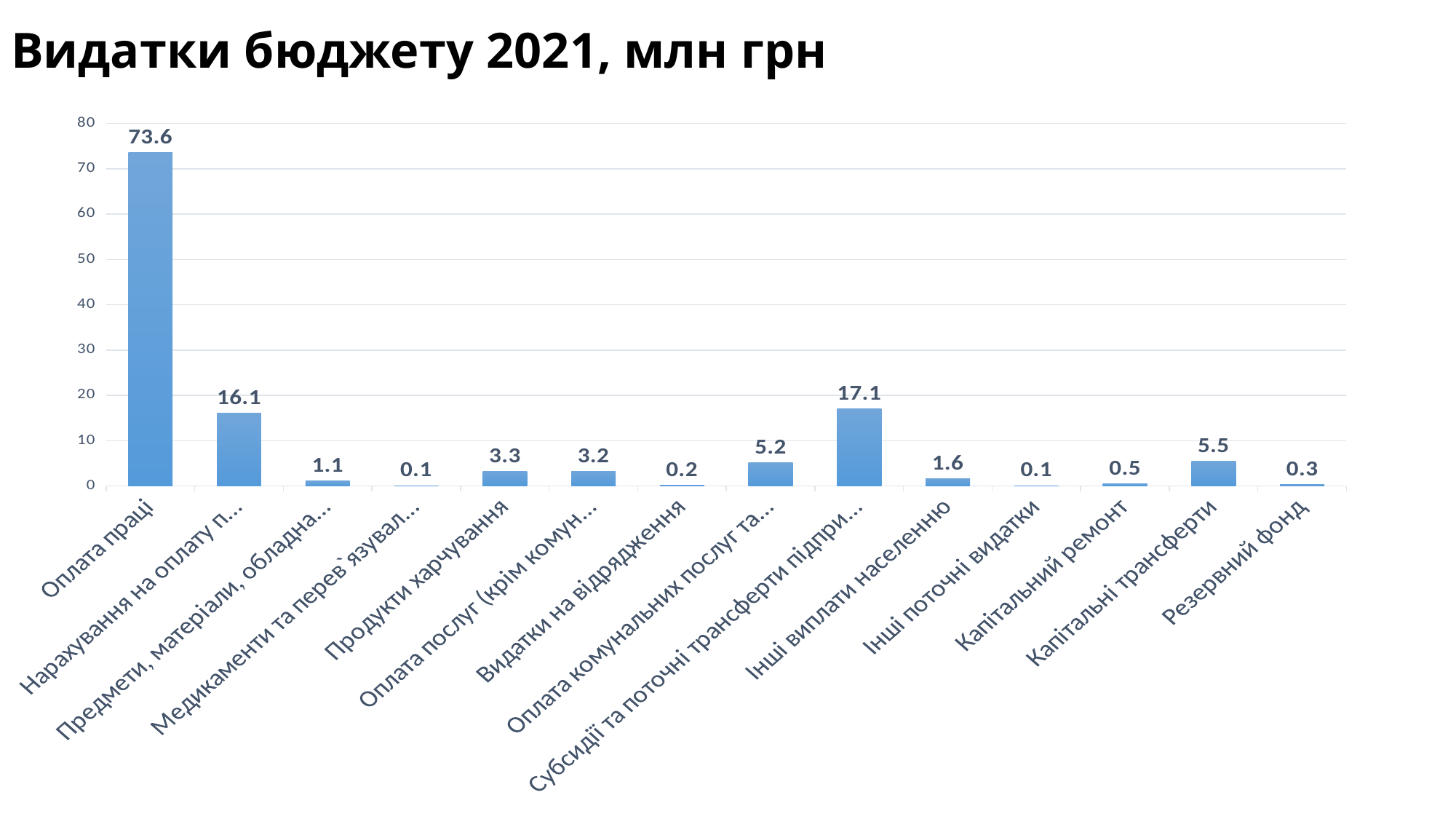
What is the difference between the values for Оплата праці and Нарахування на оплату п...? 57.5 What is the value for Інші виплати населенню? 1.6 What is the value for Резервний фонд? 0.3 What is the title of the chart? Видатки бюджету 2021, млн грн How many categories are shown in the chart? 14 What is the value for Капітальні трансферти? 5.5 Is the value for Субсидії та поточні трансферти підпри... greater or less than 10? greater What is the value for Оплата праці? 73.6 What kind of chart is shown on the slide? bar chart Which is larger, the value for Капітальні трансферти or the value for Капітальний ремонт? Капітальні трансферти Which category has the highest value? Оплата праці What is the value for Продукти харчування? 3.3